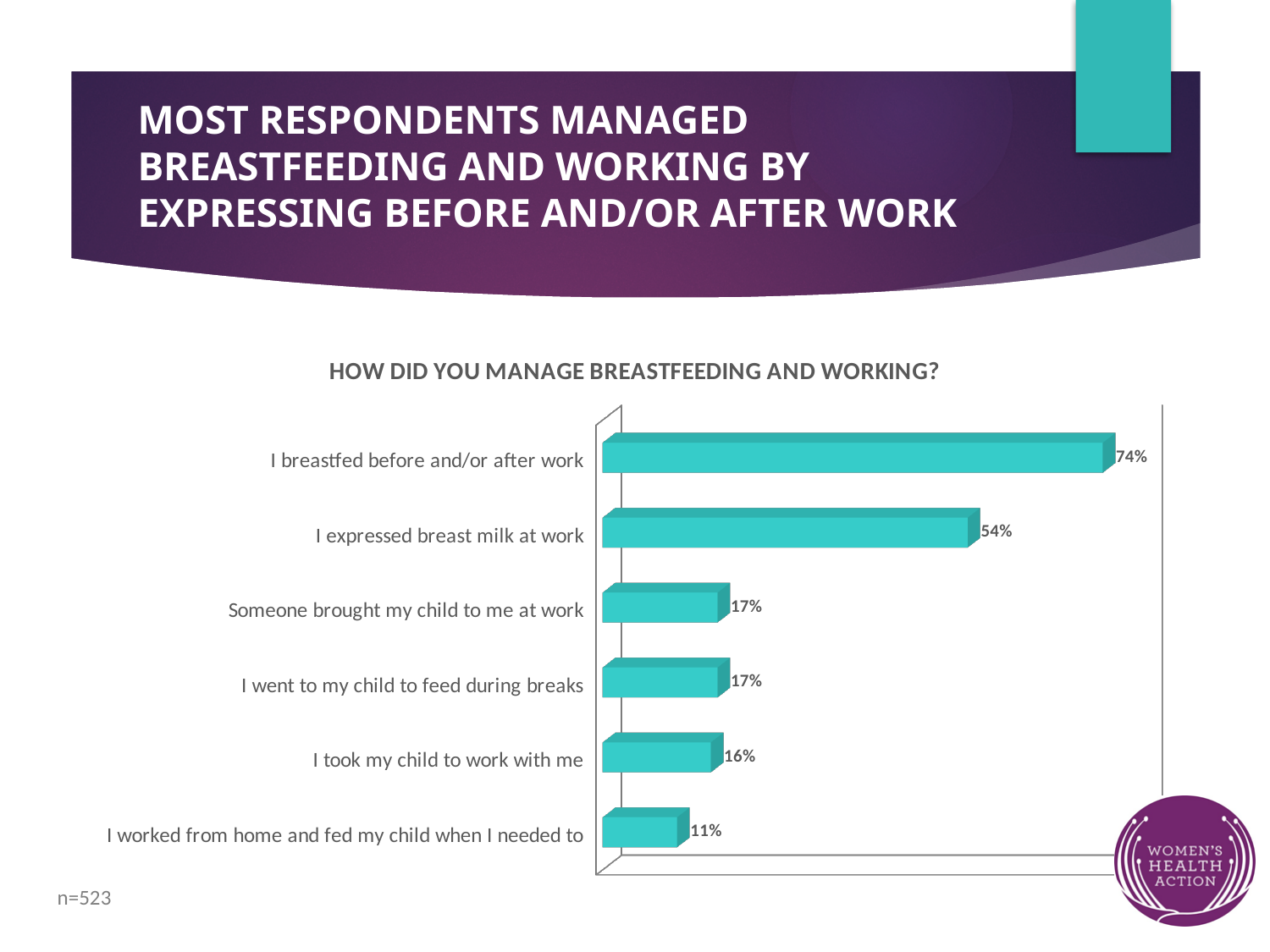
Which response has the lowest percentage? I worked from home and fed my child when I needed to What percentage of respondents said they breastfed before and/or after work? 74% How many response categories are shown in the chart? 6 What is the difference in percentage points between 'I breastfed before and/or after work' and 'I expressed breast milk at work'? 20 percentage points What percentage of respondents expressed breast milk at work? 54% What is the sample size (n) noted on the slide? n=523 Which response has the highest percentage? I breastfed before and/or after work Which is larger: the percentage for 'I took my child to work with me' or 'I worked from home and fed my child when I needed to'? I took my child to work with me What is the title of the chart? HOW DID YOU MANAGE BREASTFEEDING AND WORKING? What percentage of respondents worked from home and fed their child when needed? 11% What percentage of respondents took their child to work with them? 16% What type of chart is shown on the slide? Bar chart